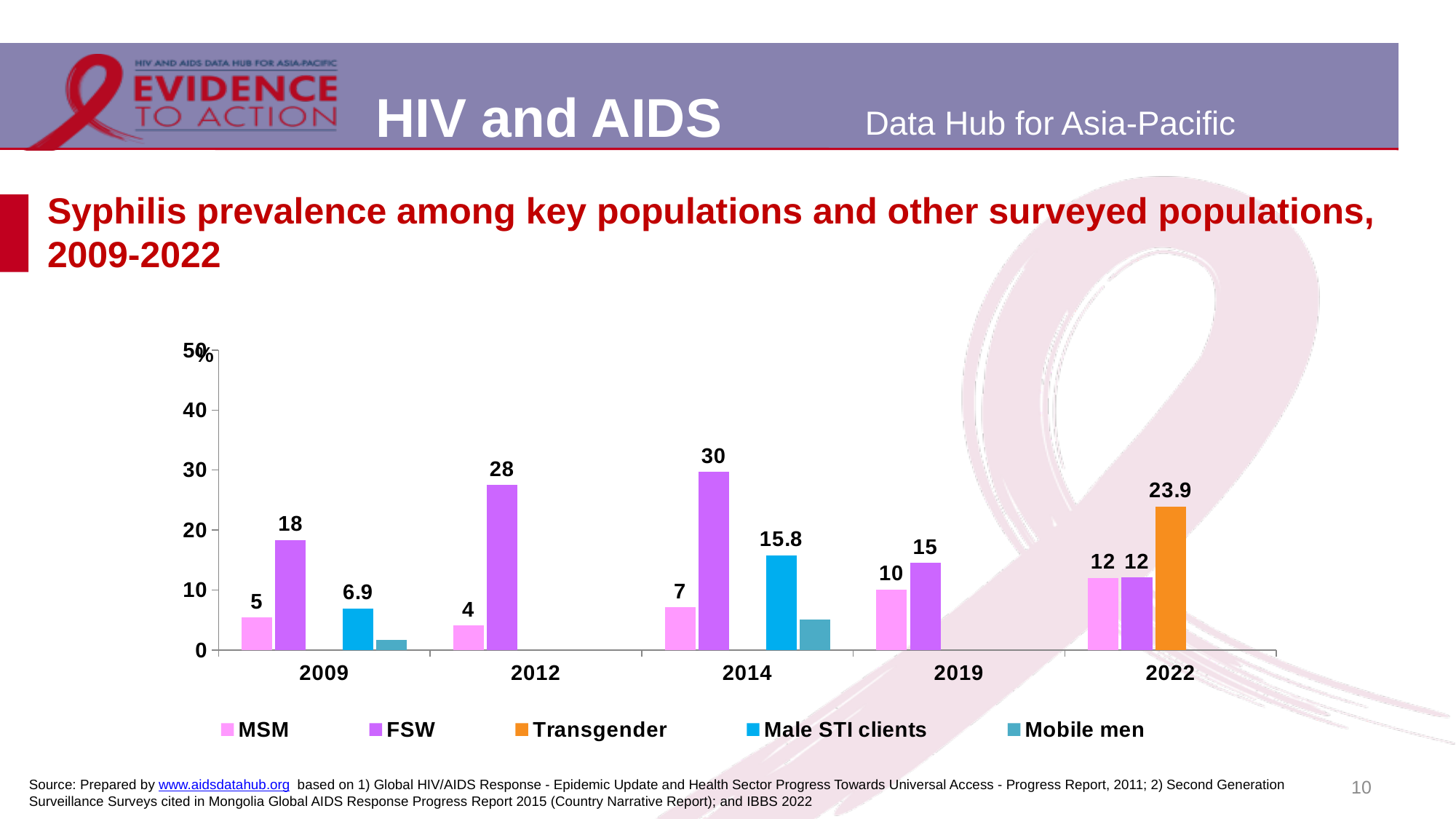
What is the difference between the FSW and MSM values in 2012? 24 In which year is the MSM value lowest? 2012 What kind of chart is shown on the slide? Bar chart What is the syphilis prevalence among MSM in 2019? 10 How many years are shown on the x axis? 5 What is the syphilis prevalence among Male STI clients in 2009? 6.9 What is the syphilis prevalence among Transgender people in 2022? 23.9 What is the syphilis prevalence among FSW in 2014? 30 In which year is the FSW value highest? 2014 How many series does the legend list? 5 Is the value for Mobile men in 2014 greater or less than 10? less Which is larger in 2009: the FSW value or the Male STI clients value? FSW